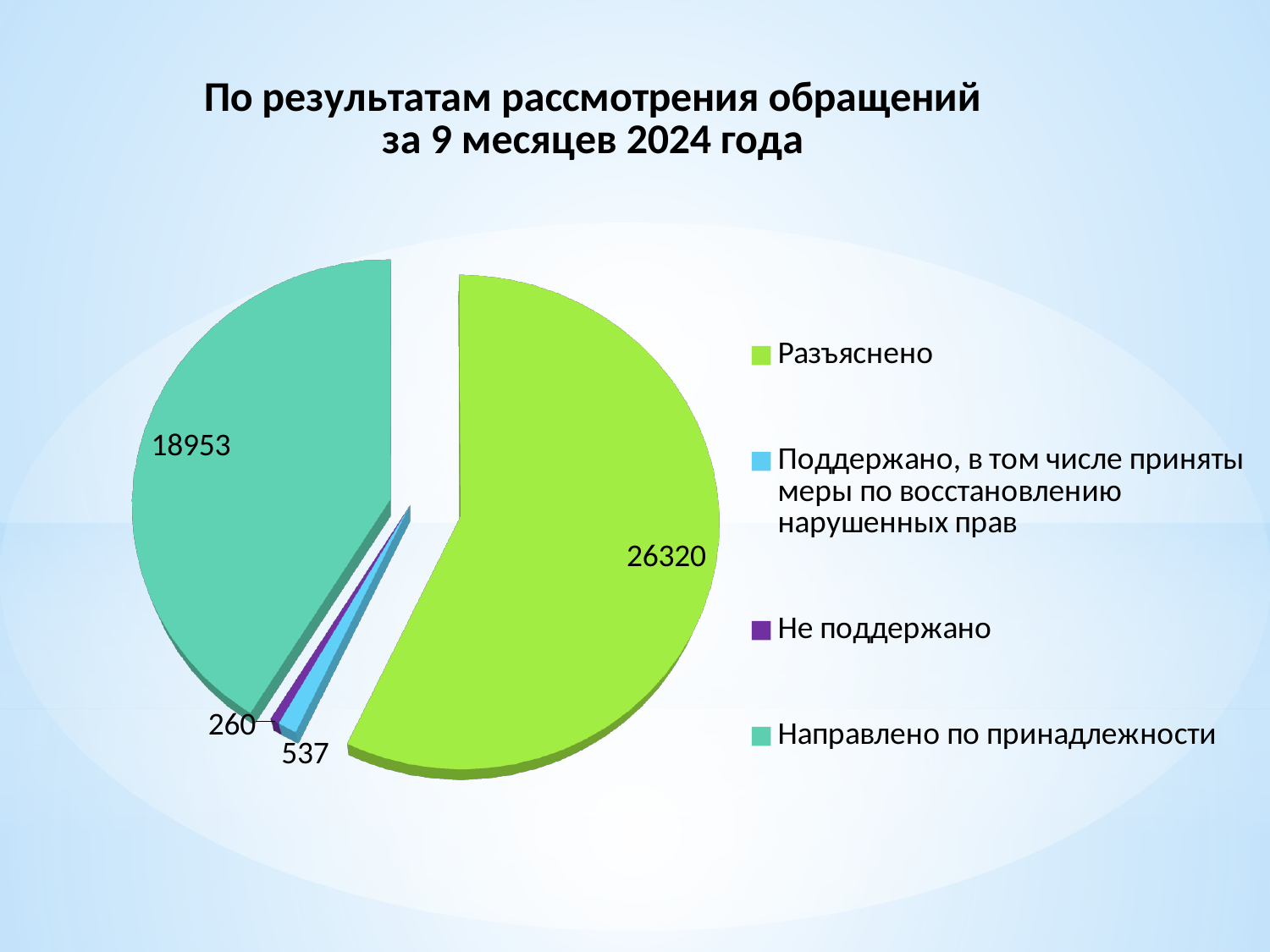
How many categories does the pie chart have? 4 Which category has the largest slice of the pie? Разъяснено What is the value for Направлено по принадлежности? 18953 What is the value for Разъяснено? 26320 What type of chart is shown on the slide? Pie chart Which is larger: Поддержано or Не поддержано? Поддержано What is the difference between the values for Поддержано and Не поддержано? 277 What is the difference between the values for Разъяснено and Направлено по принадлежности? 7367 Which category has the smallest slice of the pie? Не поддержано What is the value for Поддержано, в том числе приняты меры по восстановлению нарушенных прав? 537 What is the value for Не поддержано? 260 What is the title of the chart on the slide? По результатам рассмотрения обращений за 9 месяцев 2024 года